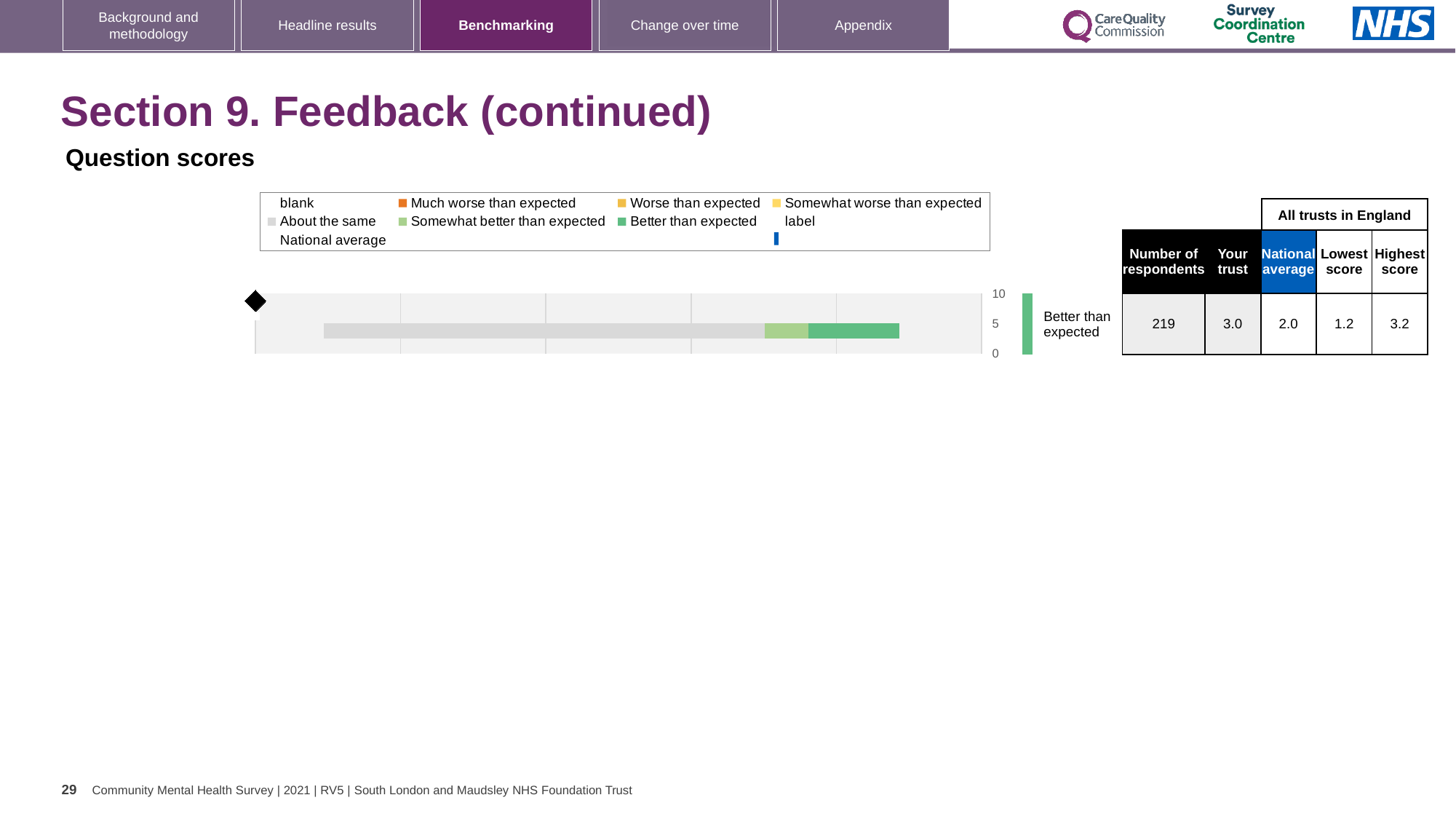
What is the highest tick value shown on the chart's vertical axis? 10 What rating label is shown next to the chart's bar? Better than expected In the table beside the chart, what is the National average score? 2.0 In the table beside the chart, how many respondents are listed? 219 In the table beside the chart, what is the Lowest score among all trusts in England? 1.2 What is the difference between the 'Your trust' score and the National average in the table beside the chart? 1.0 How many bars are plotted in the chart? 1 Which is larger in the table beside the chart: the 'Your trust' score or the National average? Your trust In the table beside the chart, what is the Highest score among all trusts in England? 3.2 What kind of chart is shown under 'Question scores'? bar chart In the table beside the chart, what is the 'Your trust' score? 3.0 Which legend entry is shown in orange? Much worse than expected